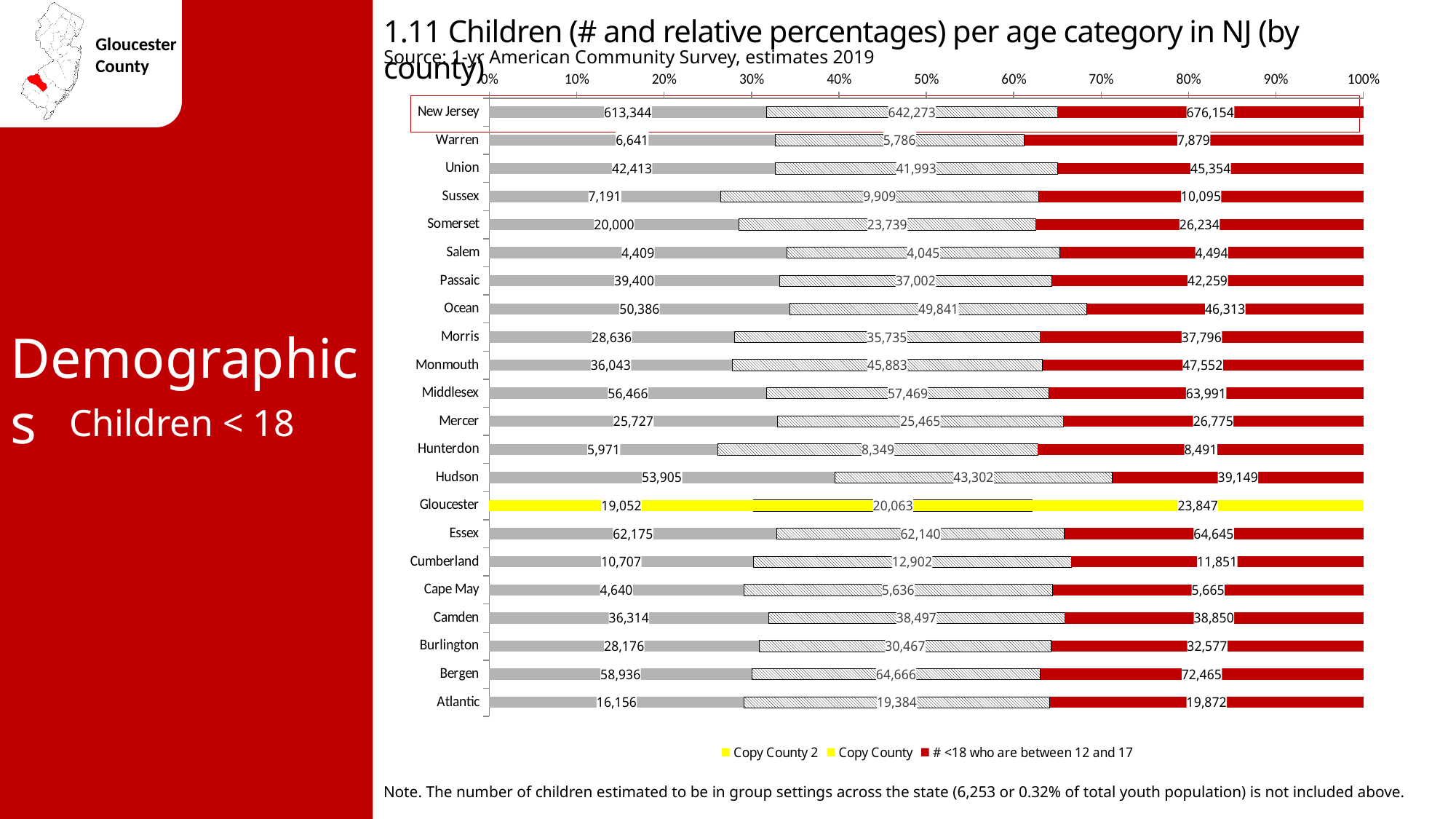
Among the counties (excluding the New Jersey row), which has the smallest '# <18 who are between 12 and 17' value? Salem What is the difference between the '# <18 who are between 12 and 17' value and the first segment value for Bergen? 13,529 What is the total of the three labelled segments for Gloucester? 62,962 What kind of chart is shown on the slide? Stacked bar chart How many rows (categories) are plotted on the chart? 22 What is the value of the first (leftmost) segment for Gloucester? 19,052 How many series does the legend list? 3 What is the value of the '# <18 who are between 12 and 17' segment for New Jersey? 676,154 Among the counties (excluding the New Jersey row), which has the largest '# <18 who are between 12 and 17' value? Bergen Is the share of the first (leftmost) segment for Hudson greater or less than 30%? greater Which is larger: the first segment value for Hudson or the first segment value for Ocean? Hudson What is the value of the '# <18 who are between 12 and 17' segment for Gloucester? 23,847